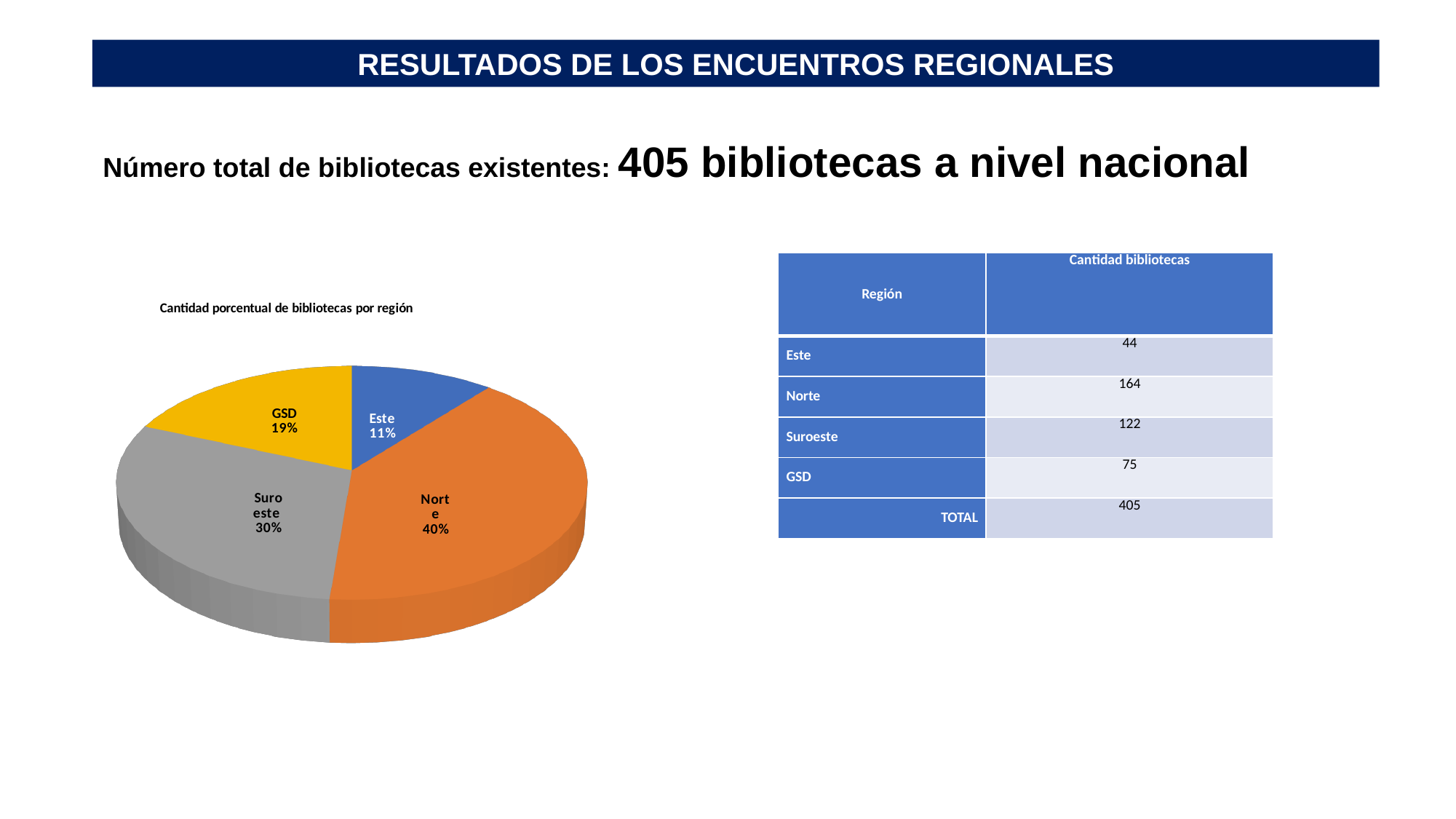
What colour is the Suroeste slice of the pie? grey What share of the pie does Norte represent? 40% What share of the pie does Suroeste represent? 30% How many slices does the pie chart have? 4 What is the difference in percentage points between the Norte and Este slices? 29 What share of the pie does Este represent? 11% What kind of chart is shown on the slide? pie chart Which region has the largest slice of the pie? Norte Which slice is larger, Suroeste or GSD? Suroeste Which region has the smallest slice of the pie? Este What is the title of the pie chart? Cantidad porcentual de bibliotecas por región